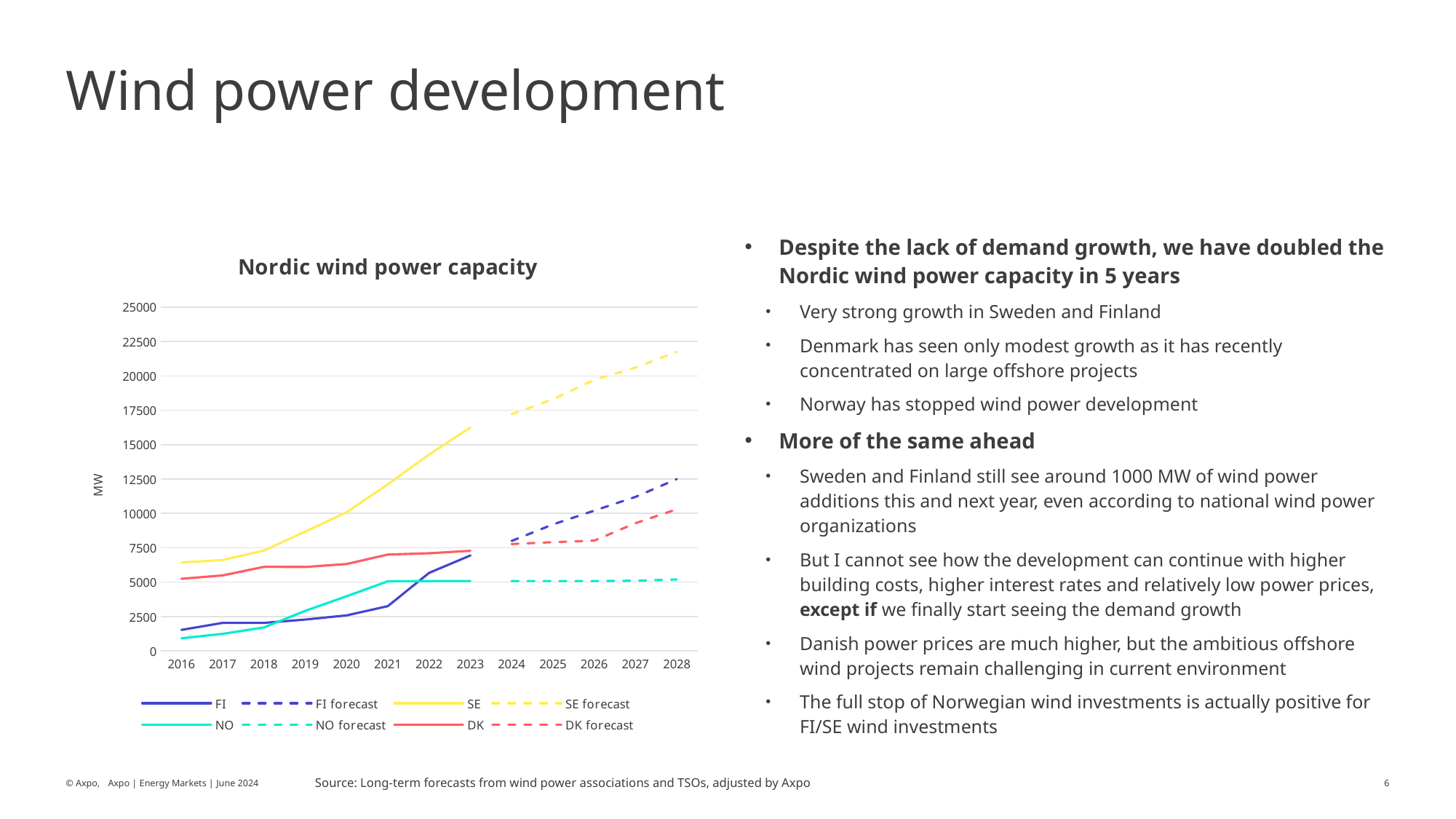
What is the title of the chart? Nordic wind power capacity Is the value for SE in 2023 greater or less than 15000? greater Is the value for FI in 2016 greater or less than 2500? less Does the SE line rise or fall from 2016 to 2023? rise Which country has the highest wind power capacity in 2023? SE Which country has the lowest wind power capacity in 2016? NO Is the value for FI forecast in 2028 greater or less than 10000? greater How many series does the chart legend list? 8 What kind of chart is shown on the slide? line chart How many years are shown on the x axis of the chart? 13 Which is larger in 2021, the value for NO or the value for FI? NO